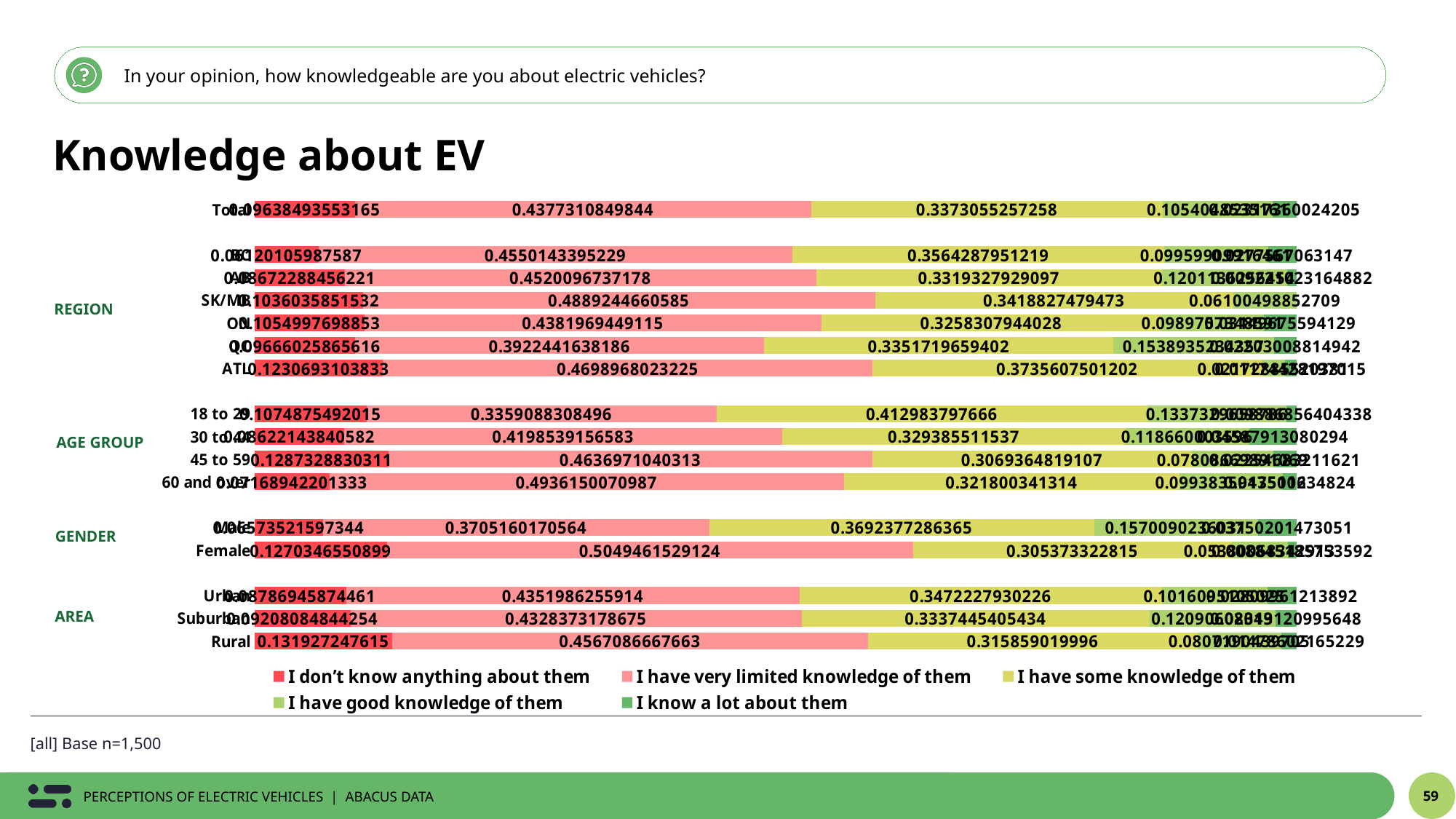
Among the AGE GROUP categories, which has the lowest value for 'I have very limited knowledge of them'? 18 to 29 How many series does the legend list? 5 Among the REGION categories, which has the highest value for 'I have very limited knowledge of them'? SK/MB Which has the larger value for 'I have very limited knowledge of them', Male or Female? Female What is the value for Rural in the 'I don't know anything about them' series? 0.131927247615 What is the value for Female in the 'I have very limited knowledge of them' series? 0.5049461529124 What is the value for 18 to 29 in the 'I have some knowledge of them' series? 0.412983797666 What is the value for Total in the 'I have very limited knowledge of them' series? 0.4377310849844 What is the value for SK/MB in the 'I have good knowledge of them' series? 0.06100498852709 What is the difference between Female and Male in the 'I have very limited knowledge of them' series? 0.134430135856 What is the value for Urban in the 'I have some knowledge of them' series? 0.3472227930226 What kind of chart is shown on the slide? Stacked bar chart